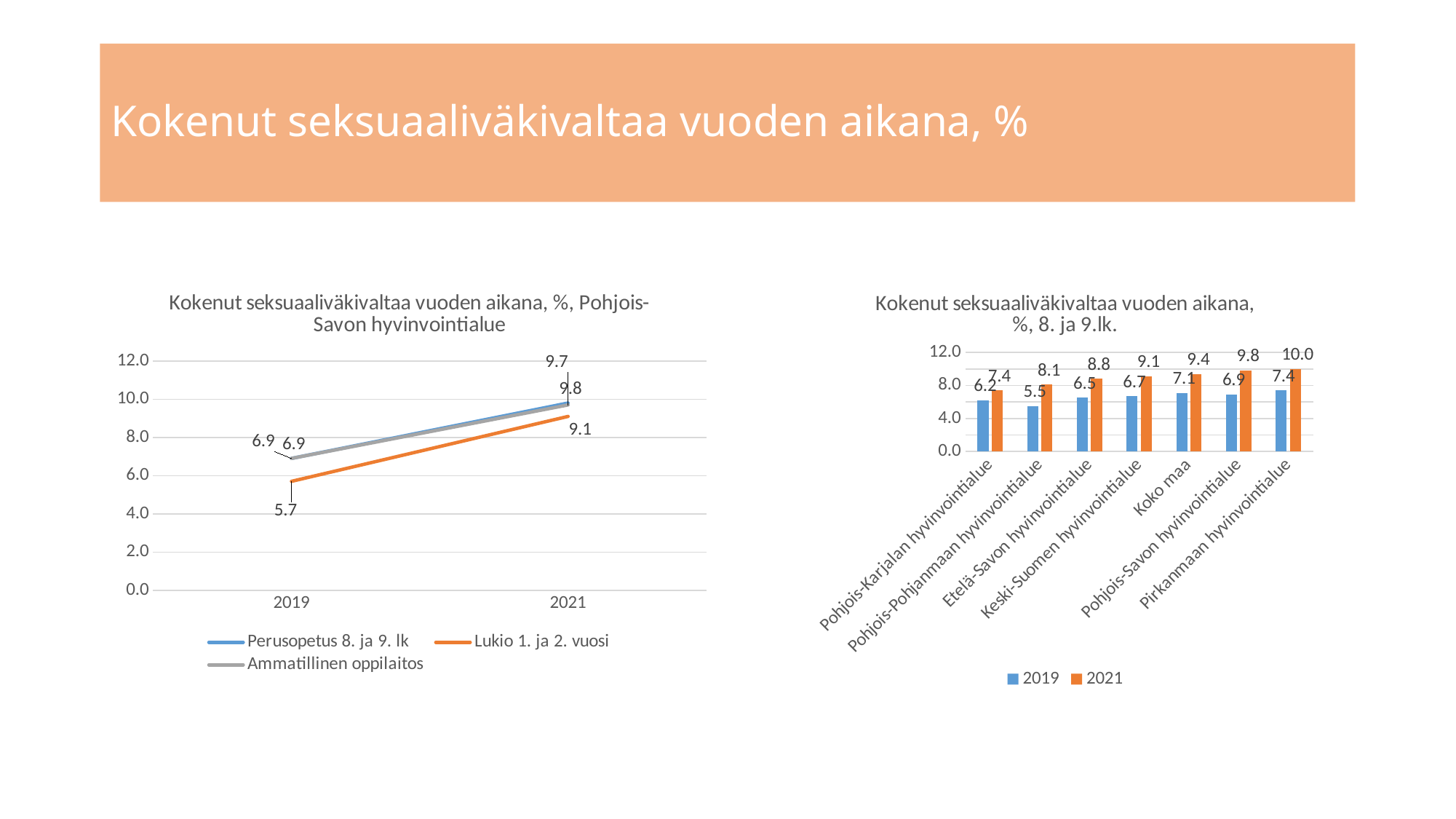
In the left-hand chart (Pohjois-Savon hyvinvointialue), what is the 2019 value for Lukio 1. ja 2. vuosi? 5.7 In the right-hand chart (8. ja 9.lk.), what is the 2019 value for Pohjois-Pohjanmaan hyvinvointialue? 5.5 In the left-hand chart (Pohjois-Savon hyvinvointialue), how many series does the legend list? 3 In the left-hand chart (Pohjois-Savon hyvinvointialue), what is the 2021 value for Lukio 1. ja 2. vuosi? 9.1 In the right-hand chart (8. ja 9.lk.), how many categories are shown on the x axis? 7 In the right-hand chart (8. ja 9.lk.), what is the 2021 value for Pirkanmaan hyvinvointialue? 10.0 In the left-hand chart (Pohjois-Savon hyvinvointialue), do the values rise or fall from 2019 to 2021? Rise What kind of chart is the right-hand chart (8. ja 9.lk.)? Bar chart In the right-hand chart (8. ja 9.lk.), which category has the highest 2021 value? Pirkanmaan hyvinvointialue In the right-hand chart (8. ja 9.lk.), which category has the lowest 2019 value? Pohjois-Pohjanmaan hyvinvointialue In the right-hand chart (8. ja 9.lk.), what is the difference between the 2021 and 2019 values for Pohjois-Savon hyvinvointialue? 2.9 In the right-hand chart (8. ja 9.lk.), how many series does the legend list? 2